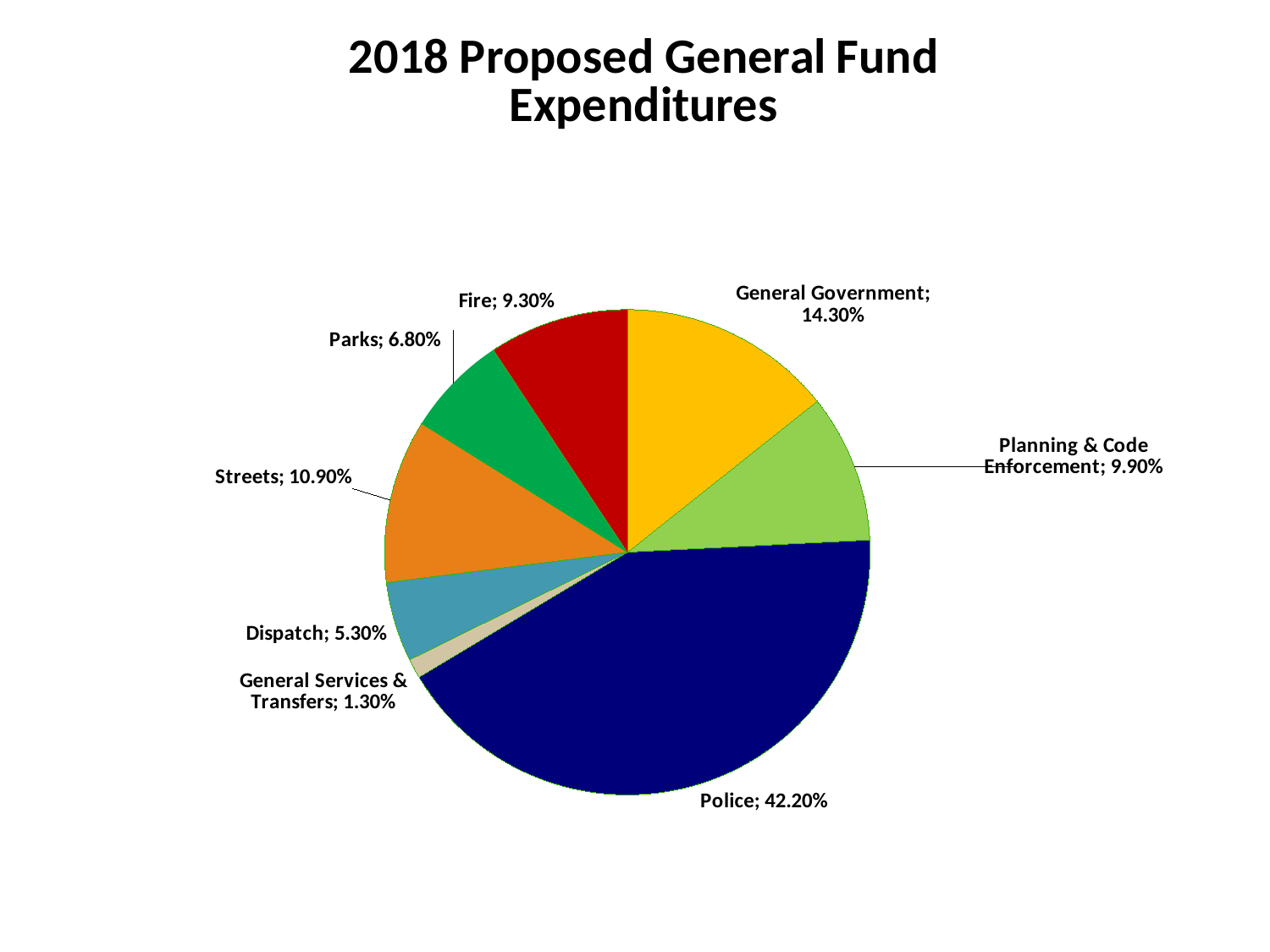
Which category has the smallest share of expenditures? General Services & Transfers How many categories are shown in the pie chart? 8 What kind of chart is shown on the slide? pie chart What share of expenditures goes to General Services & Transfers? 1.30% What is the title of the chart? 2018 Proposed General Fund Expenditures What share of expenditures goes to Police? 42.20% What is the difference in percentage points between the Police share and the General Government share? 27.90 Which category has the largest share of expenditures? Police What is the difference in percentage points between Planning & Code Enforcement and Dispatch? 4.60 Which has a larger share, Fire or Parks? Fire What share of expenditures goes to General Government? 14.30% What share of expenditures goes to Streets? 10.90%